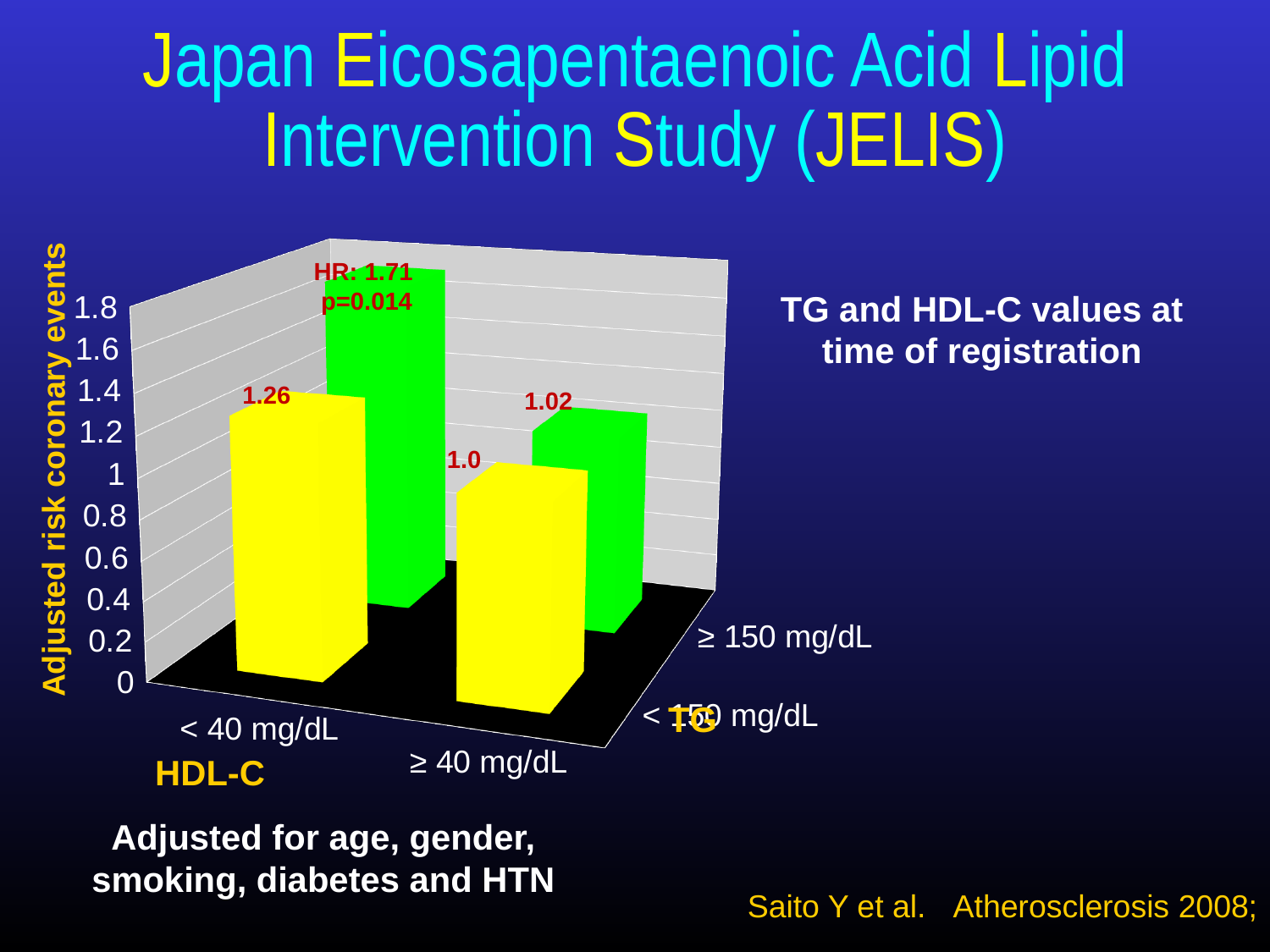
What is the adjusted risk of coronary events for HDL-C ≥ 40 mg/dL and TG < 150 mg/dL? 1.0 Which HDL-C and TG combination has the highest adjusted risk of coronary events? HDL-C < 40 mg/dL and TG ≥ 150 mg/dL What type of chart is shown on the slide? bar chart What is the adjusted risk of coronary events for HDL-C ≥ 40 mg/dL and TG ≥ 150 mg/dL? 1.02 What is the difference in adjusted risk between the HDL-C < 40 mg/dL, TG ≥ 150 mg/dL group and the HDL-C < 40 mg/dL, TG < 150 mg/dL group? 0.45 How many bars are plotted in the chart? 4 What is the adjusted risk of coronary events for HDL-C < 40 mg/dL and TG ≥ 150 mg/dL? 1.71 What is the adjusted risk of coronary events for HDL-C < 40 mg/dL and TG < 150 mg/dL? 1.26 Is the adjusted risk for HDL-C < 40 mg/dL and TG ≥ 150 mg/dL greater or less than 1.6? greater Which HDL-C and TG combination has the lowest adjusted risk of coronary events? HDL-C ≥ 40 mg/dL and TG < 150 mg/dL Which has a higher adjusted risk: HDL-C < 40 mg/dL with TG < 150 mg/dL, or HDL-C ≥ 40 mg/dL with TG ≥ 150 mg/dL? HDL-C < 40 mg/dL with TG < 150 mg/dL What p-value is shown next to the HR: 1.71 label on the chart? p=0.014